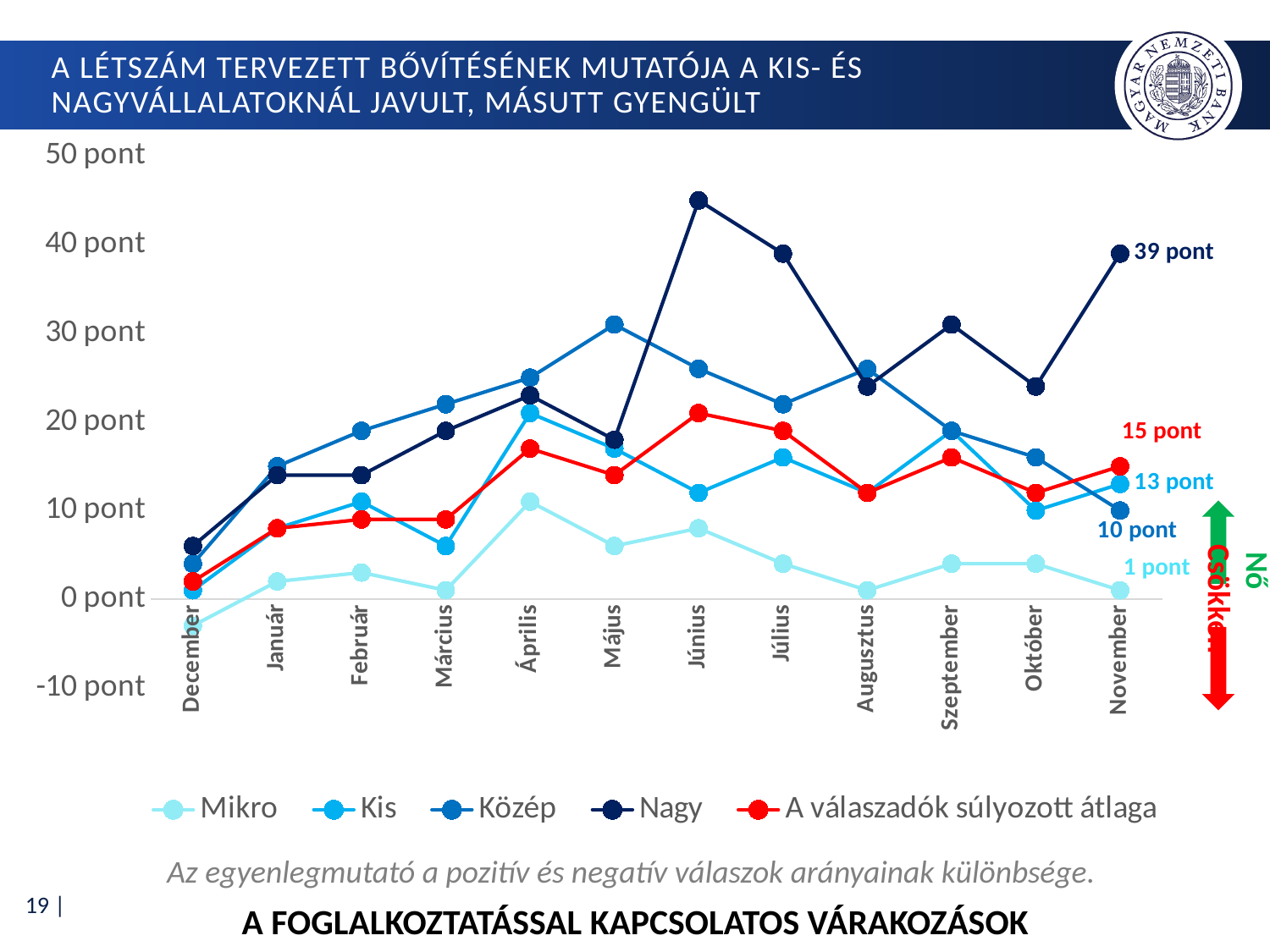
What is the value of 'A válaszadók súlyozott átlaga' in November? 15 pont Which series has the lowest value in November? Mikro Is the value for Nagy in Június greater or less than 40 pont? greater In November, which is larger: the Közép value or the Kis value? Kis What is the value of the Kis series in November? 13 pont What is the difference between the Nagy and Kis values in November? 26 pont How many series does the legend list? 5 What kind of chart is shown on the slide? line chart What is the value of the Nagy series in November? 39 pont What is the value of the Mikro series in November? 1 pont How many months are shown on the x axis? 12 Which series has the highest value in November? Nagy